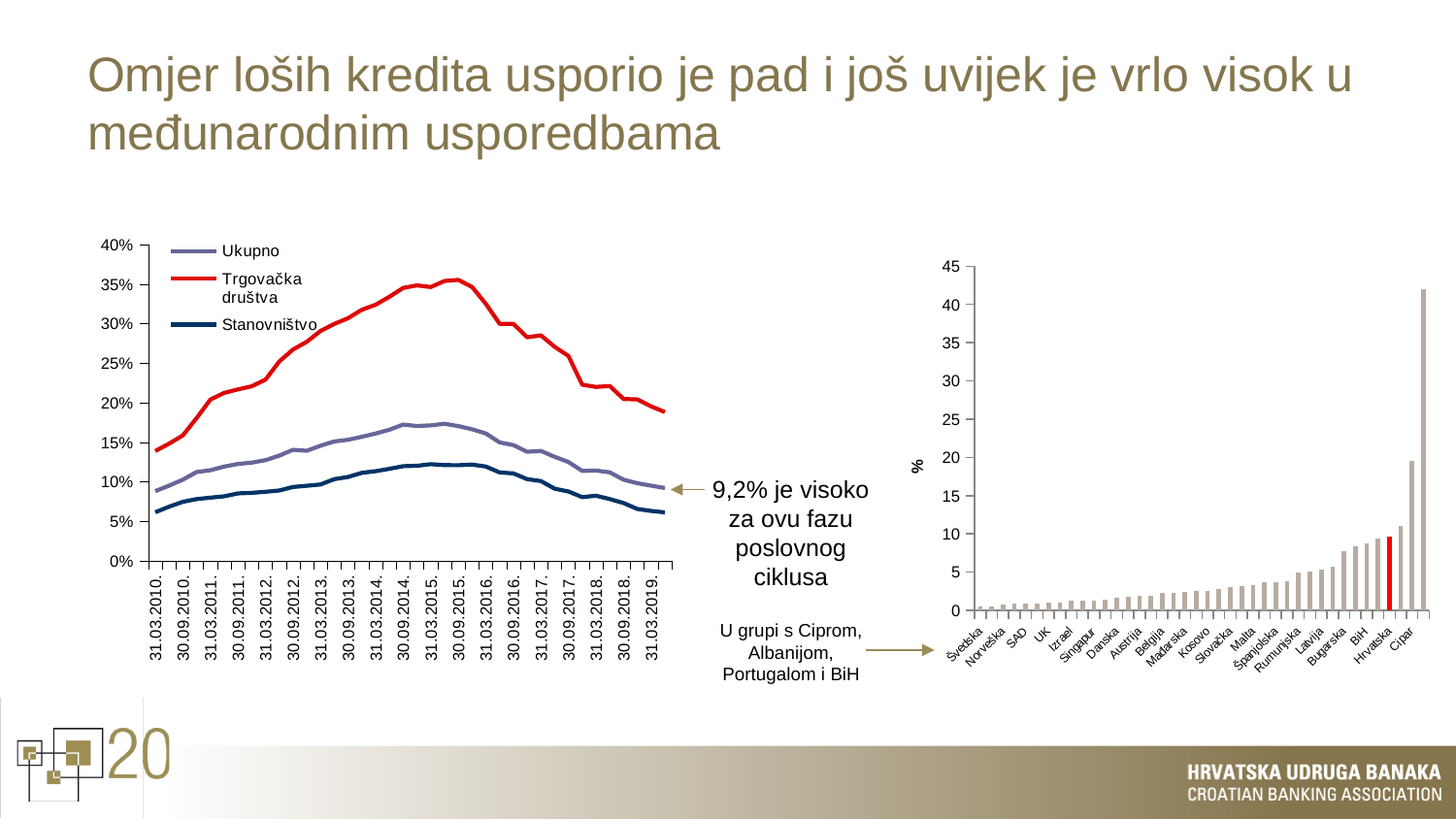
In the right chart, is the value for Hrvatska greater or less than 5? greater In the left chart, does the Trgovačka društva series rise or fall between 30.09.2015 and 31.03.2019? fall In the left chart, which series has the lowest values throughout the period? Stanovništvo In the right chart, is the value for Cipar greater or less than 40? less How many series does the legend of the left chart list? 3 In the left chart, is the value for Stanovništvo at 31.03.2019 greater or less than 10%? less What kind of chart is the chart on the right side of the slide? bar chart What kind of chart is the chart on the left side of the slide? line chart In the left chart, which series has the highest values throughout the period? Trgovačka društva In the right chart, which country's bar is highlighted in red? Hrvatska